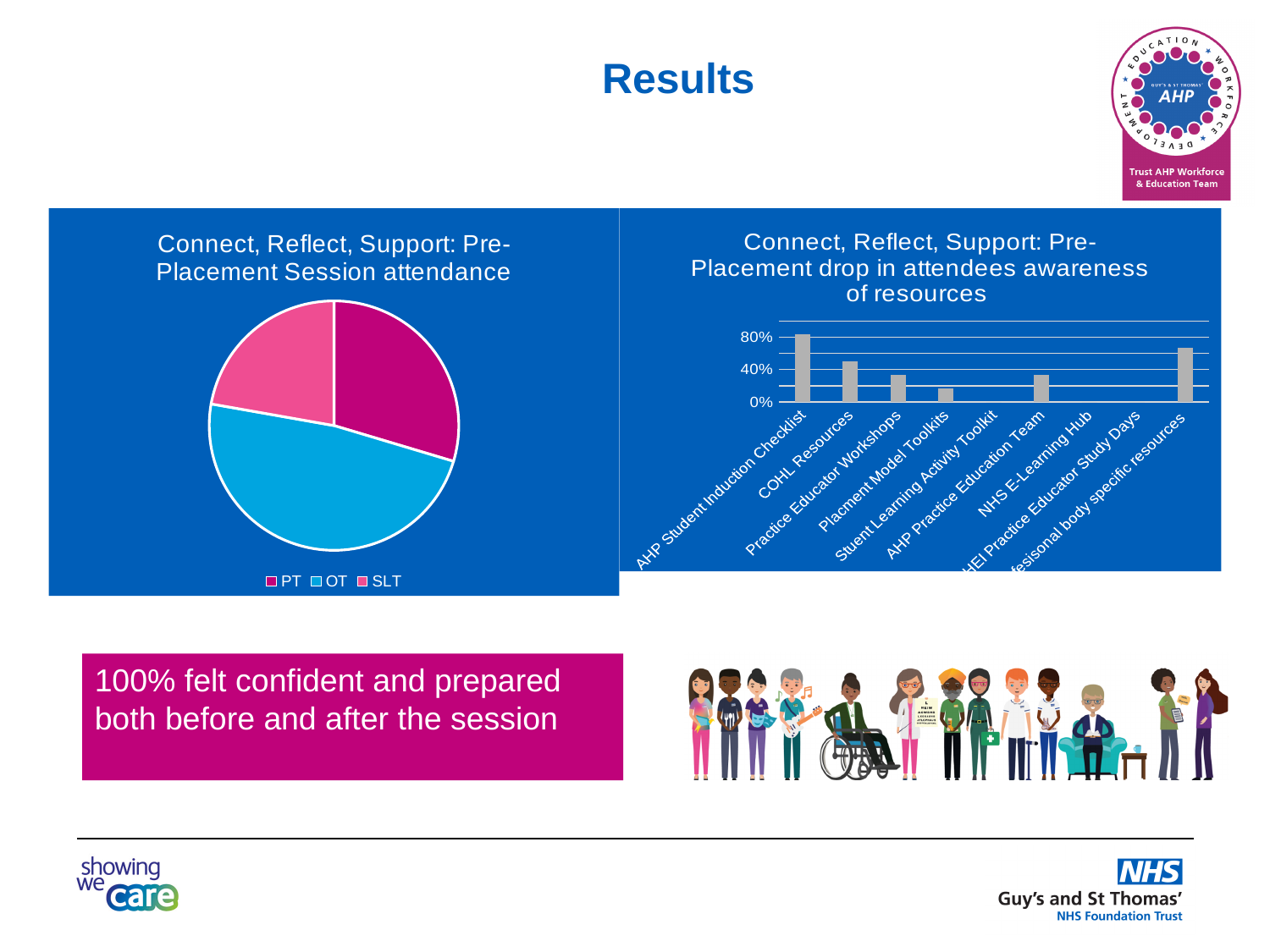
In the 'Pre-Placement Session attendance' pie chart, which profession has the smallest slice? SLT In the 'Pre-Placement drop in attendees awareness of resources' bar chart, is the value for Professional body specific resources greater or less than 40%? greater What kind of chart is the 'Pre-Placement drop in attendees awareness of resources' chart? bar chart In the 'Pre-Placement Session attendance' pie chart, what colour is the OT slice? light blue In the 'Pre-Placement Session attendance' pie chart, how many categories does the legend list? 3 In the 'Pre-Placement drop in attendees awareness of resources' bar chart, which resource has the highest bar? AHP Student Induction Checklist What kind of chart is the 'Connect, Reflect, Support: Pre-Placement Session attendance' chart? pie chart In the 'Pre-Placement Session attendance' pie chart, which profession has the largest slice? OT In the 'Pre-Placement drop in attendees awareness of resources' bar chart, is the value for Placement Model Toolkits greater or less than 40%? less In the 'Pre-Placement drop in attendees awareness of resources' bar chart, how many resource categories are shown on the x axis? 9 In the 'Pre-Placement Session attendance' pie chart, which slice is larger, PT or SLT? PT In the 'Pre-Placement drop in attendees awareness of resources' bar chart, which is larger, the value for AHP Student Induction Checklist or for COHL Resources? AHP Student Induction Checklist